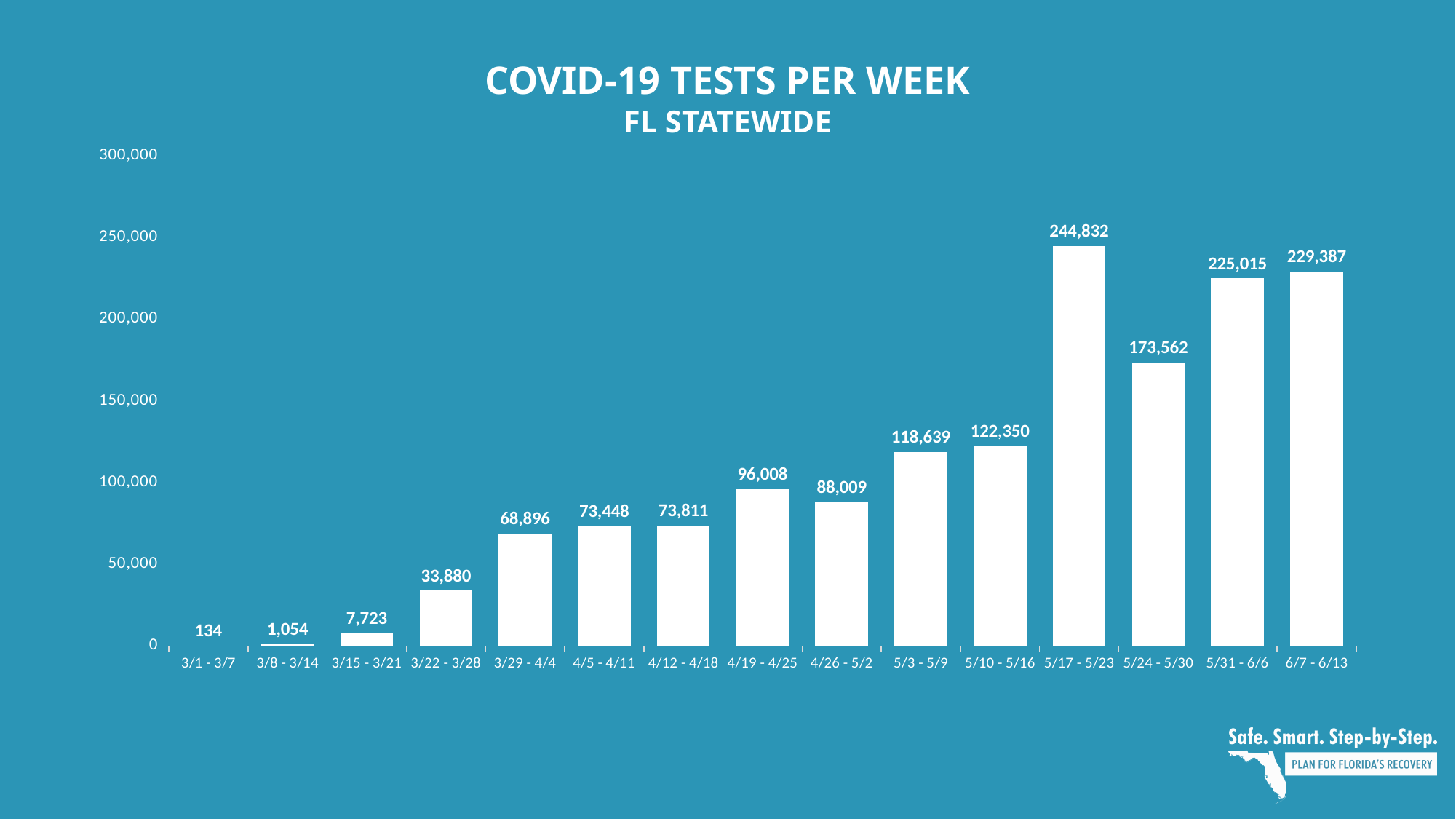
Do the weekly test counts generally rise or fall from 3/1 - 3/7 to 5/17 - 5/23? Rise What is the number of COVID-19 tests for the week 6/7 - 6/13? 229,387 What is the number of COVID-19 tests for the week 3/22 - 3/28? 33,880 What is the title of the chart? COVID-19 TESTS PER WEEK FL STATEWIDE Which week had more tests, 4/19 - 4/25 or 4/26 - 5/2? 4/19 - 4/25 What is the number of COVID-19 tests for the week 5/17 - 5/23? 244,832 What kind of chart is shown on the slide? Bar chart Which week has the highest number of tests? 5/17 - 5/23 Which week has the lowest number of tests? 3/1 - 3/7 Is the value for the week 5/3 - 5/9 greater or less than 100,000? greater How many weeks are shown on the chart? 15 What is the difference in tests between the weeks 5/17 - 5/23 and 5/24 - 5/30? 71,270